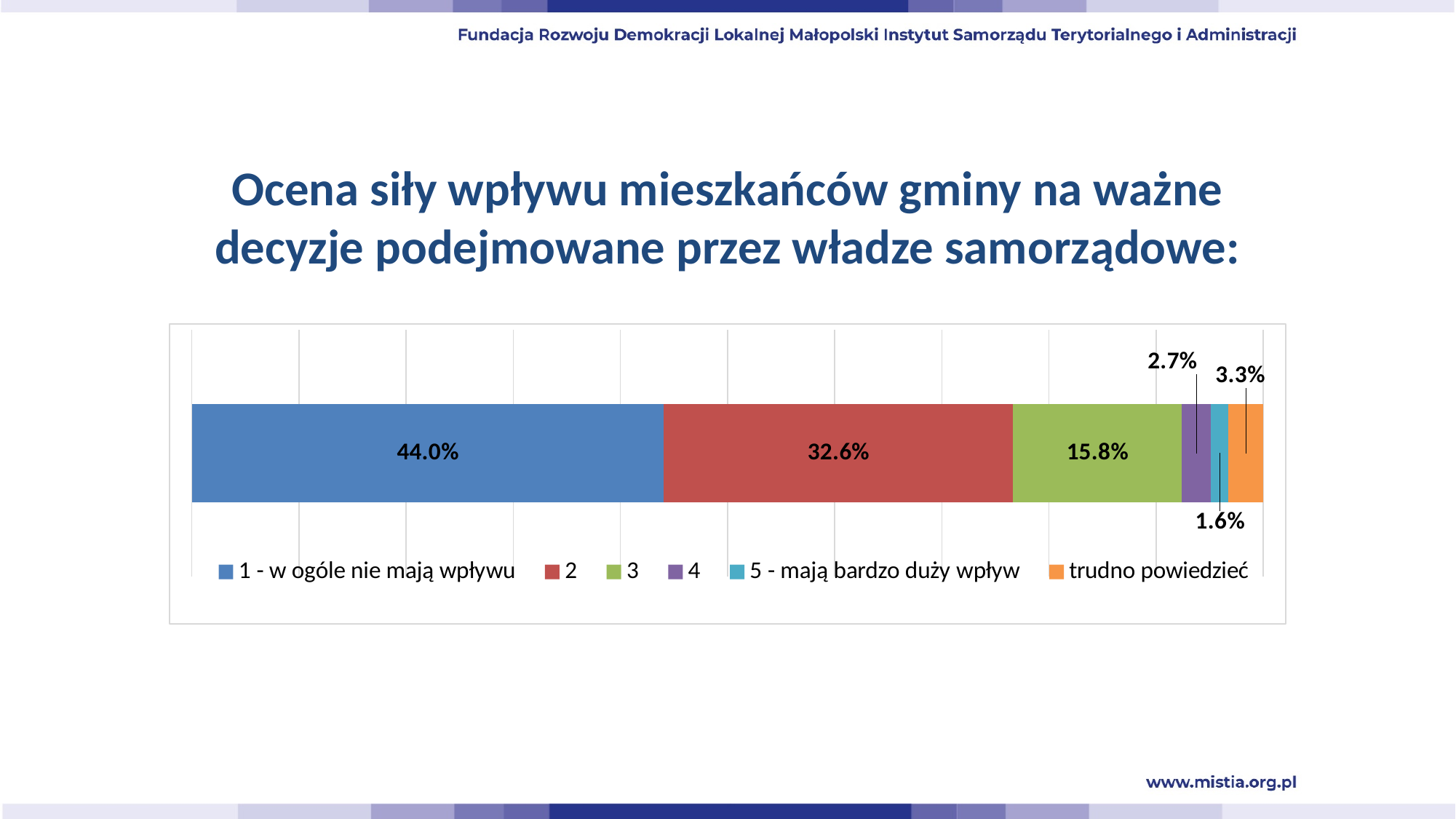
What percentage is shown for "5 - mają bardzo duży wpływ"? 1.6% What percentage is shown for "trudno powiedzieć"? 3.3% How many series does the legend list? 6 What is the difference between the shares for "1 - w ogóle nie mają wpływu" and "2"? 11.4% What is the value shown for the "3" segment? 15.8% What kind of chart is shown on the slide? Stacked bar chart What percentage of respondents chose "1 - w ogóle nie mają wpływu"? 44.0% Which is larger: the share for "4" or the share for "trudno powiedzieć"? trudno powiedzieć Which response category has the smallest share? 5 - mają bardzo duży wpływ What is the value shown for the "2" segment of the bar? 32.6% Which response category has the largest share? 1 - w ogóle nie mają wpływu What is the total of all segments in the stacked bar? 100.0%